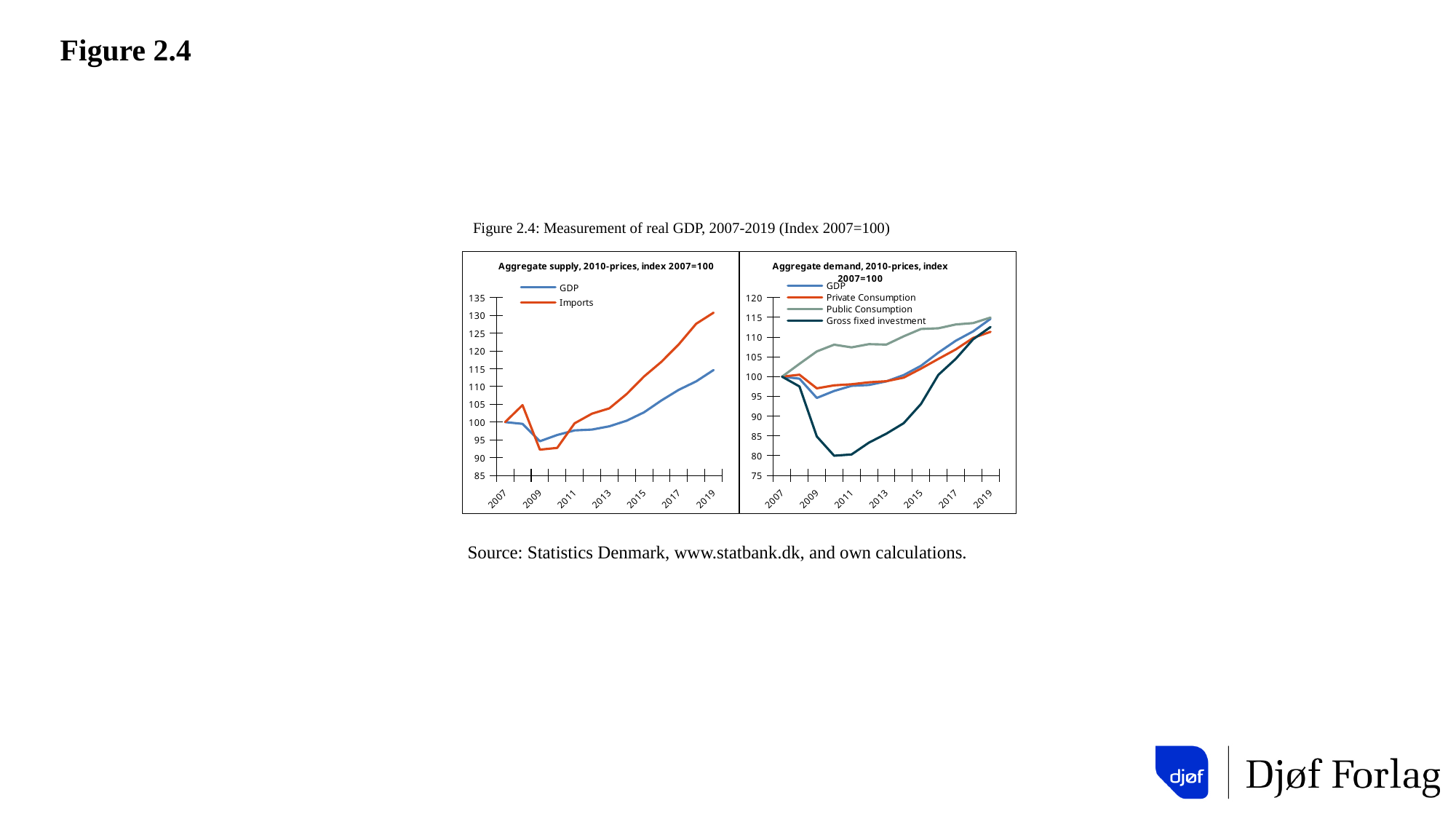
In the left chart (Aggregate supply), is the value for GDP in 2019 greater or less than 110? greater In the right chart (Aggregate demand), which series has the highest value in 2013? Public Consumption How many series does the legend of the left chart (Aggregate supply) list? 2 In the left chart (Aggregate supply), which series has the higher value in 2019, GDP or Imports? Imports In the right chart (Aggregate demand), which series has the lowest value in 2010? Gross fixed investment What is the title of the right chart? Aggregate demand, 2010-prices, index 2007=100 In the left chart (Aggregate supply), do the values for Imports rise or fall from 2010 to 2019? Rise In the right chart (Aggregate demand), is the value for Gross fixed investment in 2010 greater or less than 85? less How many series does the legend of the right chart (Aggregate demand) list? 4 In the left chart (Aggregate supply), what is the value of Imports in 2007? 100 What type of chart is the left chart titled 'Aggregate supply, 2010-prices, index 2007=100'? Line chart In the left chart (Aggregate supply), is the value for Imports in 2019 greater or less than 125? greater